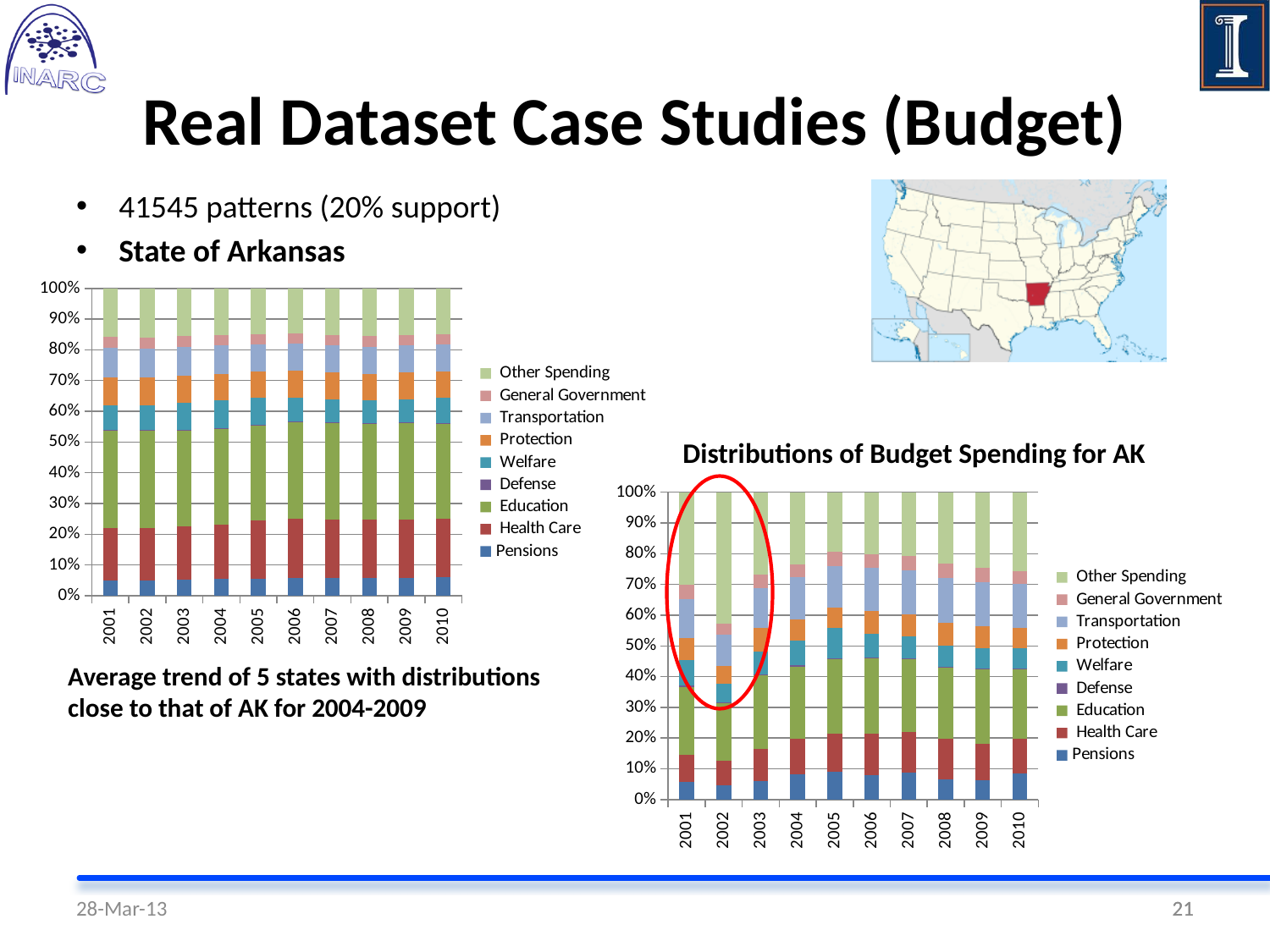
How many series does the legend of the 'Distributions of Budget Spending for AK' chart list? 9 In the 'Distributions of Budget Spending for AK' chart, is the Other Spending share larger in 2002 or in 2005? 2002 What is the title of the chart on the right side of the slide? Distributions of Budget Spending for AK What kind of chart is the chart titled 'Distributions of Budget Spending for AK'? Stacked bar chart How many years are shown on the x axis of the left chart (average trend of 5 states)? 10 In the left chart (average trend of 5 states), is the cumulative share through Education (Pensions + Health Care + Education) in 2010 greater or less than 50%? greater In the left chart (average trend of 5 states), which segment is larger in 2010, Education or Health Care? Education In the 'Distributions of Budget Spending for AK' chart, which series is at the bottom of each stacked bar? Pensions In the 'Distributions of Budget Spending for AK' chart, is the cumulative share through Education (Pensions + Health Care + Education) in 2002 greater or less than 40%? less In the 'Distributions of Budget Spending for AK' chart, which year has the largest Other Spending share? 2002 In the left chart (average trend of 5 states), is the Pensions share in 2001 greater or less than 10%? less